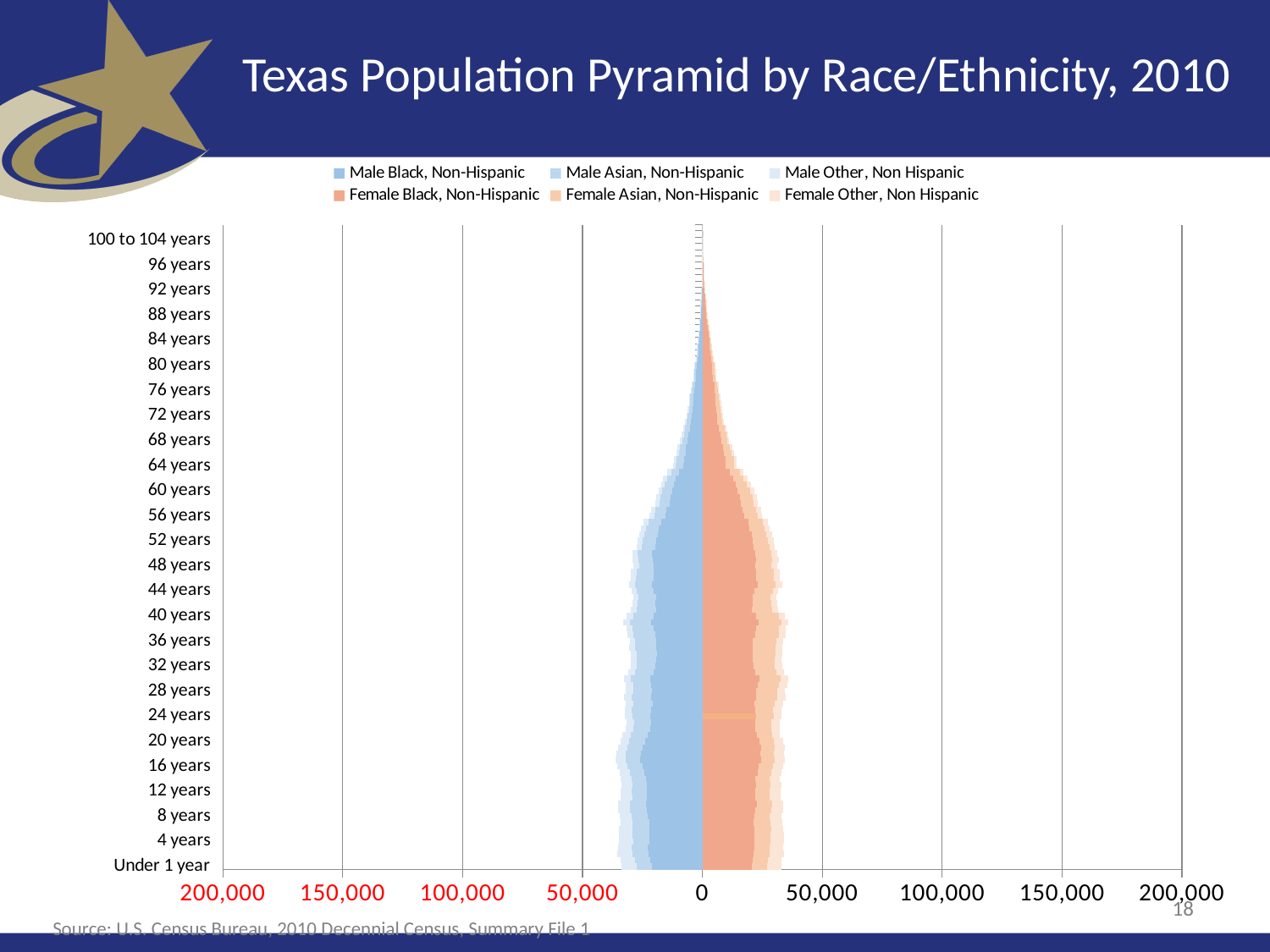
Is the total female value for 100 to 104 years greater or less than 50,000? less Which has the larger total female value, 24 years or 92 years? 24 years What is the title of the chart? Texas Population Pyramid by Race/Ethnicity, 2010 Is the total male value for 40 years greater or less than 50,000? less What kind of chart is shown on the slide? bar chart Which has the larger total male value, 40 years or 80 years? 40 years Is the total male value for 20 years greater or less than 100,000? less Do the bar lengths rise or fall as age increases from 60 years to 100 to 104 years? fall What is the largest value shown on the horizontal axis? 200,000 How many series does the legend list? 6 Which legend entry is shown in the darkest blue? Male Black, Non-Hispanic